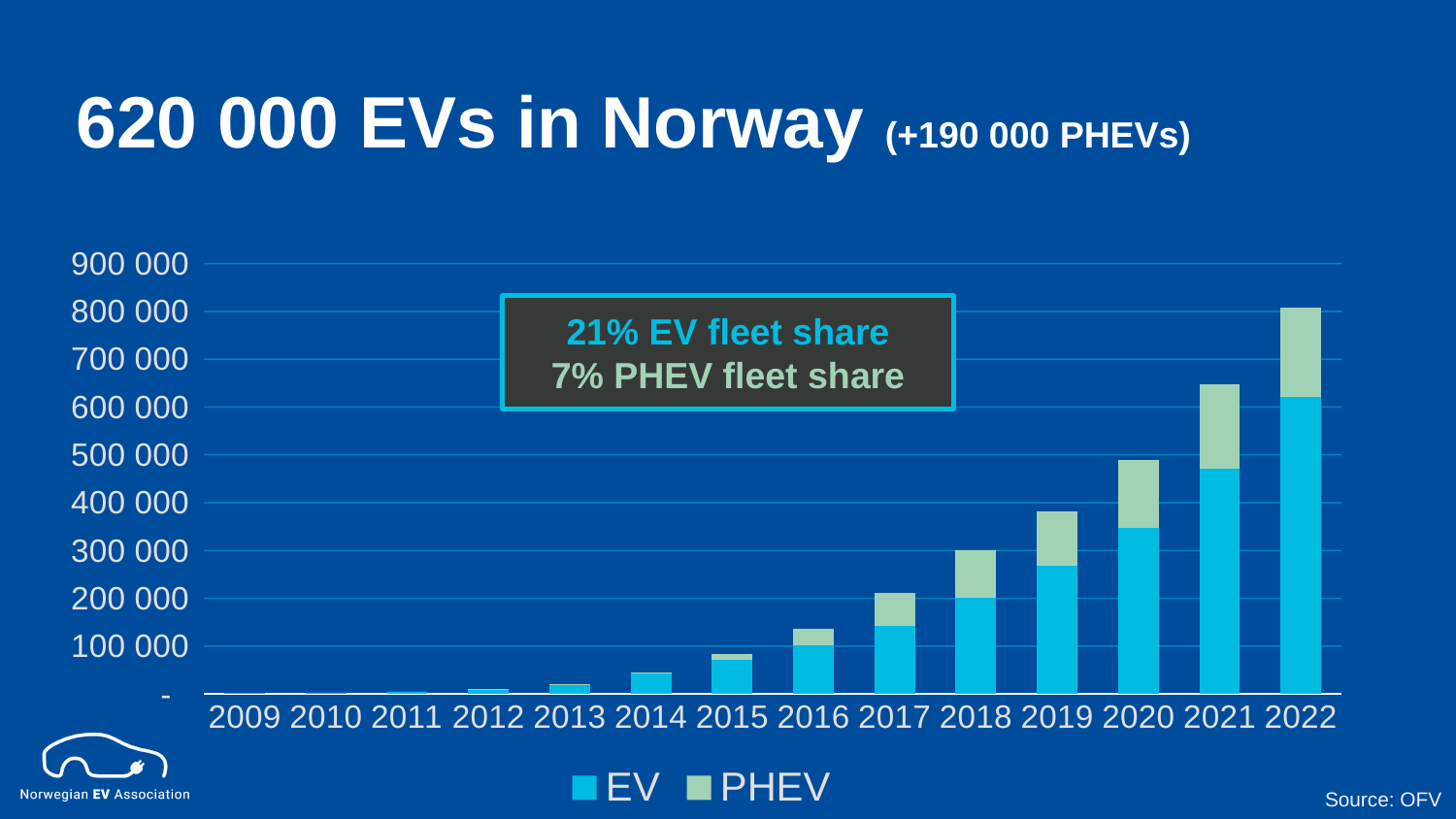
Do the stacked bar totals rise or fall from 2009 to 2022? Rise According to the text box on the chart, what is the EV fleet share? 21% How many series does the legend list? 2 How many years are shown on the x axis? 14 Which year has the smallest stacked bar? 2009 Which year has the tallest stacked bar? 2022 Is the EV value for 2021 greater or less than 500 000? less Is the total stacked bar for 2021 greater or less than 600 000? greater What kind of chart is shown on the slide? Stacked bar chart Is the total stacked bar for 2019 greater or less than 400 000? less In 2022, which series has the larger segment, EV or PHEV? EV